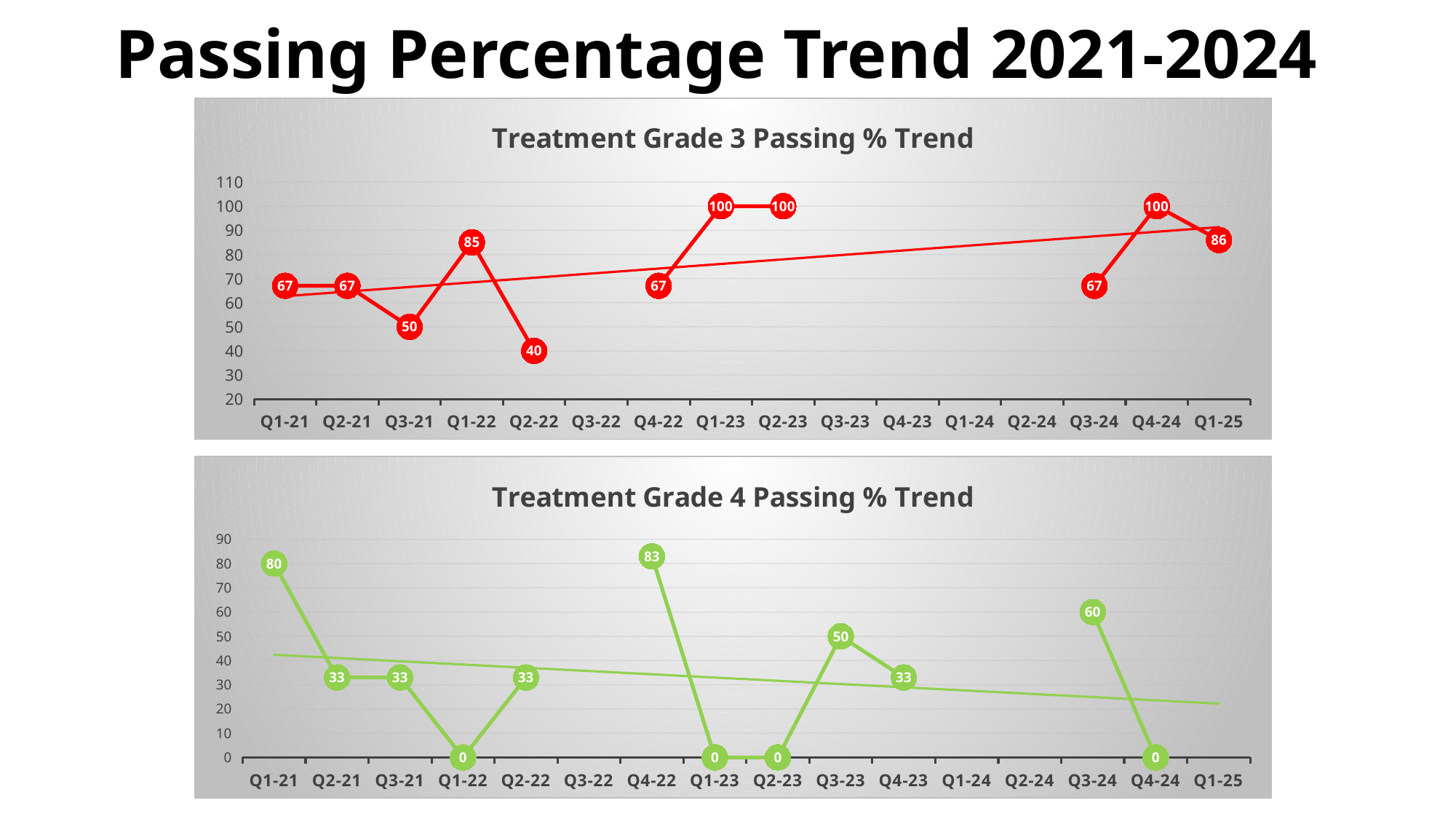
In the Treatment Grade 4 Passing % Trend chart, what is the value for Q3-24? 60 In the Treatment Grade 3 Passing % Trend chart, what is the difference between the values for Q4-24 and Q3-24? 33 In the Treatment Grade 3 Passing % Trend chart, which quarter has the lowest plotted value? Q2-22 What type of chart is the Treatment Grade 3 Passing % Trend chart? Line chart In the Treatment Grade 4 Passing % Trend chart, what is the value for Q4-22? 83 In the Treatment Grade 4 Passing % Trend chart, how many data points are plotted with a value of 0? 4 In the Treatment Grade 4 Passing % Trend chart, which is larger, the value for Q3-23 or the value for Q4-23? Q3-23 In the Treatment Grade 3 Passing % Trend chart, what is the value for Q2-22? 40 In the Treatment Grade 3 Passing % Trend chart, what is the value for Q1-25? 86 In the Treatment Grade 4 Passing % Trend chart, which quarter has the highest plotted value? Q4-22 In the Treatment Grade 4 Passing % Trend chart, does the straight trend line rise or fall from left to right? Fall In the Treatment Grade 3 Passing % Trend chart, what is the value for Q1-22? 85